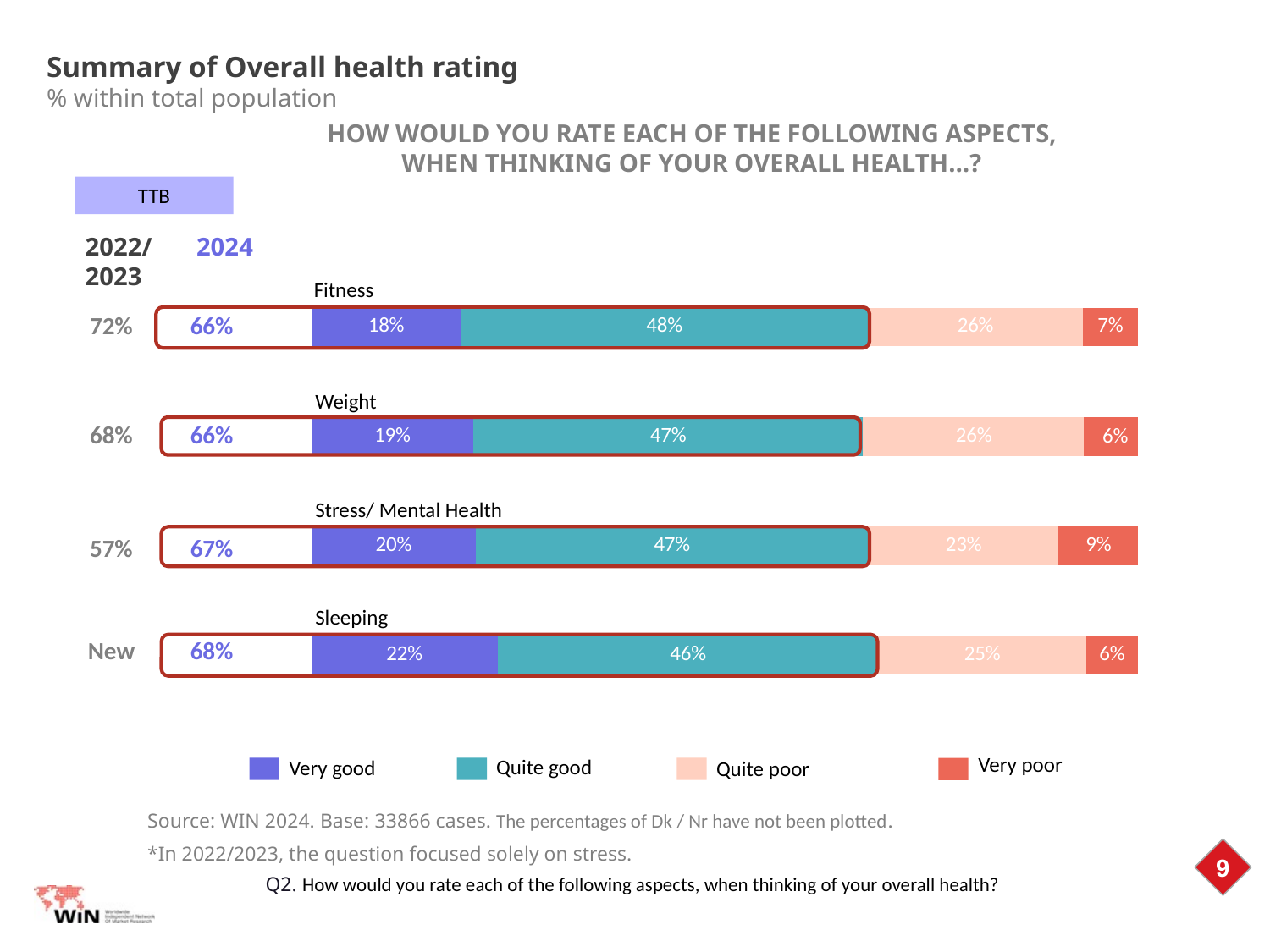
Which aspect has the highest "Very poor" percentage? Stress/ Mental Health What is the "Very good" value for Sleeping? 22% What is the difference between the "Quite poor" values for Fitness and Stress/ Mental Health? 3% What kind of chart is shown on the slide? Stacked bar chart What is the 2024 TTB value for Weight? 66% How many series does the legend list? 4 What percentage of respondents rated their Fitness as "Quite good"? 48% Which is larger: the "Very good" value for Weight or the "Very good" value for Sleeping? Sleeping What was the 2022/2023 TTB value for Fitness? 72% Which aspect has the lowest "Very good" percentage? Fitness How many aspects (categories) are plotted in the chart? 4 What is the "Very poor" value for Stress/ Mental Health? 9%